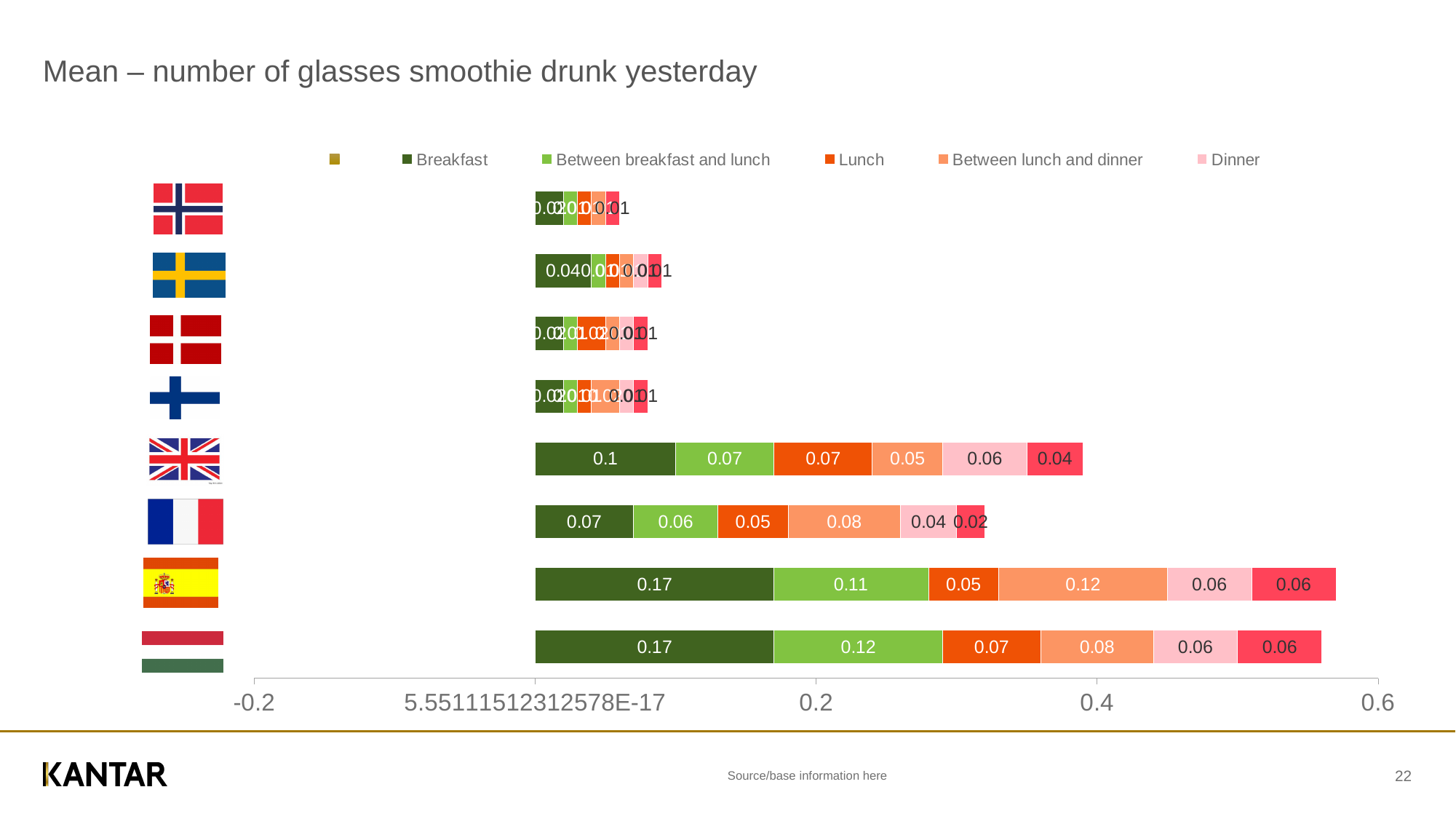
What kind of chart is shown on the slide? stacked bar chart Is the total length of the bar next to the Spanish flag greater or less than 0.4? greater How many bars (country rows) does the chart show? 8 What is the difference between the Breakfast value of the Spanish-flag bar and the Breakfast value of the UK-flag bar? 0.07 What is the Lunch value for the bar next to the UK flag (fifth from the top)? 0.07 What is the 'Between breakfast and lunch' value for the bottom bar (Hungarian flag)? 0.12 What is the Breakfast value for the bar next to the Spanish flag (seventh from the top)? 0.17 Which is larger: the Lunch value for the Spanish-flag bar or the Lunch value for the Hungarian-flag bar? Hungarian-flag bar What is the 'Between lunch and dinner' value for the bar next to the French flag (sixth from the top)? 0.08 What is the chart's title? Mean – number of glasses smoothie drunk yesterday What is the total of all segments in the bar next to the UK flag (fifth from the top)? 0.39 How many legend entries have a text label? 5